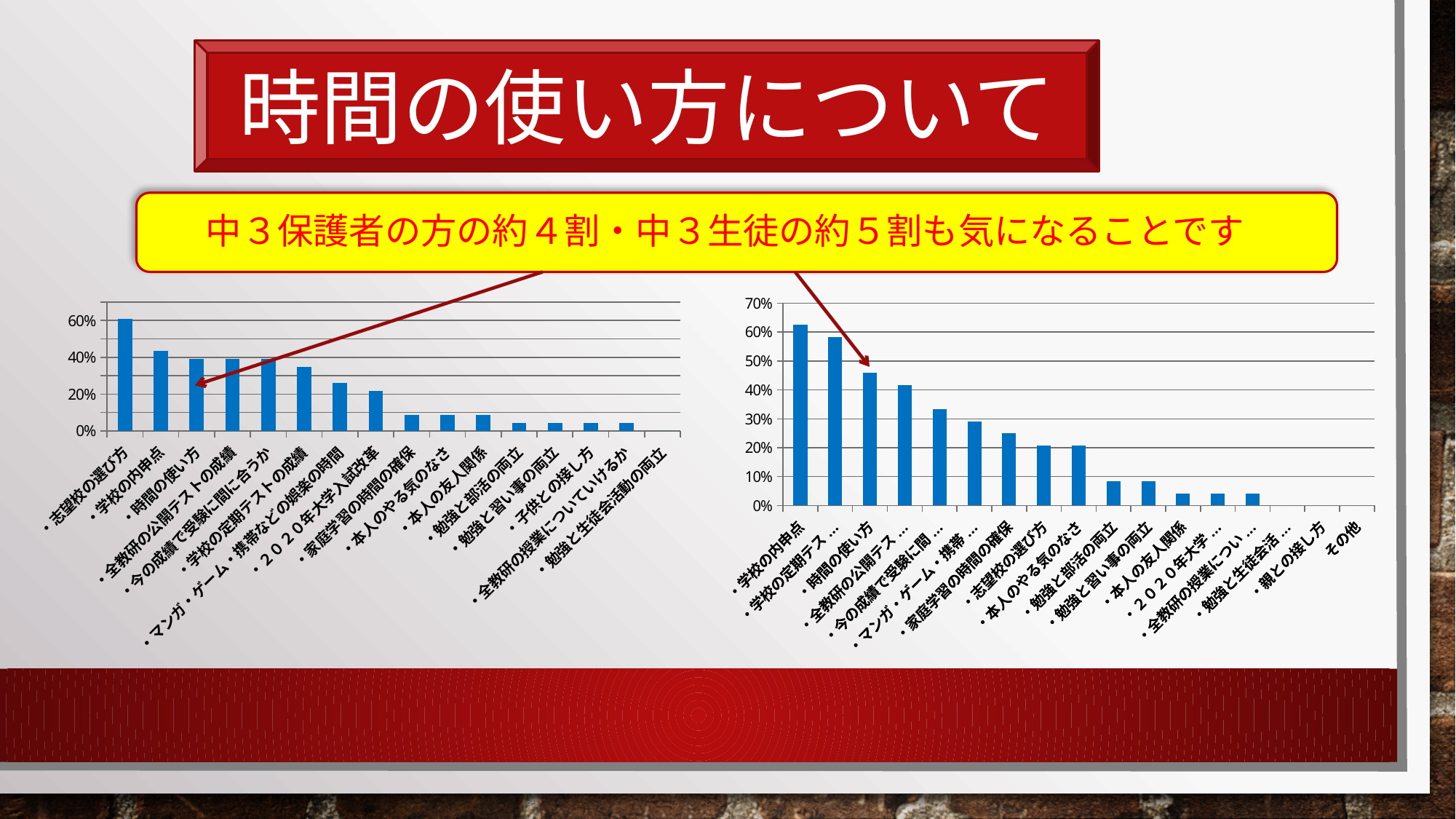
In the chart on the left, is the value for 志望校の選び方 greater or less than 40%? greater In the chart on the left, is the value for 時間の使い方 greater or less than 20%? greater In the chart on the right, is the value for 学校の内申点 greater or less than 60%? greater In the chart on the left, which category has the highest value? 志望校の選び方 How many categories are shown in the chart on the right? 17 In the chart on the right, which category has the highest value? 学校の内申点 In the chart on the right, which is larger, the value for 家庭学習の時間の確保 or the value for 勉強と部活の両立? 家庭学習の時間の確保 What kind of chart is the chart on the left of the slide? bar chart In the chart on the left, do the values rise or fall from left to right along the x axis? fall In the chart on the left, which is larger, the value for 学校の内申点 or the value for 家庭学習の時間の確保? 学校の内申点